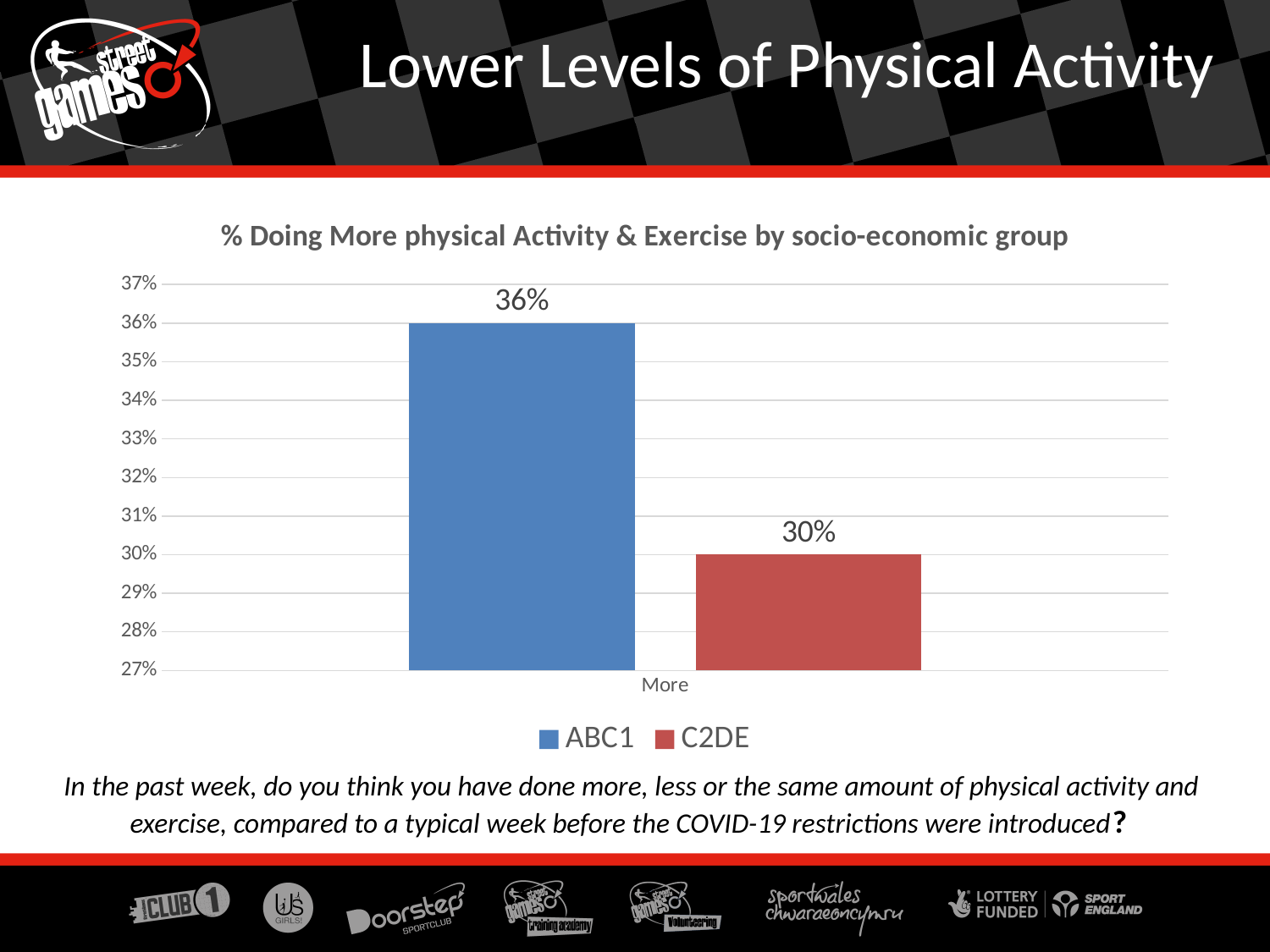
What is the category label on the x axis of the chart? More What is the difference between the ABC1 and C2DE values? 6% Which series has the lowest value in the chart? C2DE What is the title of the chart? % Doing More physical Activity & Exercise by socio-economic group Which series has the higher value, ABC1 or C2DE? ABC1 What is the value for C2DE in the chart? 30% Is the value for C2DE greater or less than 33%? less How many bars are plotted in the chart? 2 What is the value for ABC1 in the chart? 36% How many series does the legend list? 2 Is the value for ABC1 greater or less than 35%? greater What kind of chart is shown on the slide? bar chart